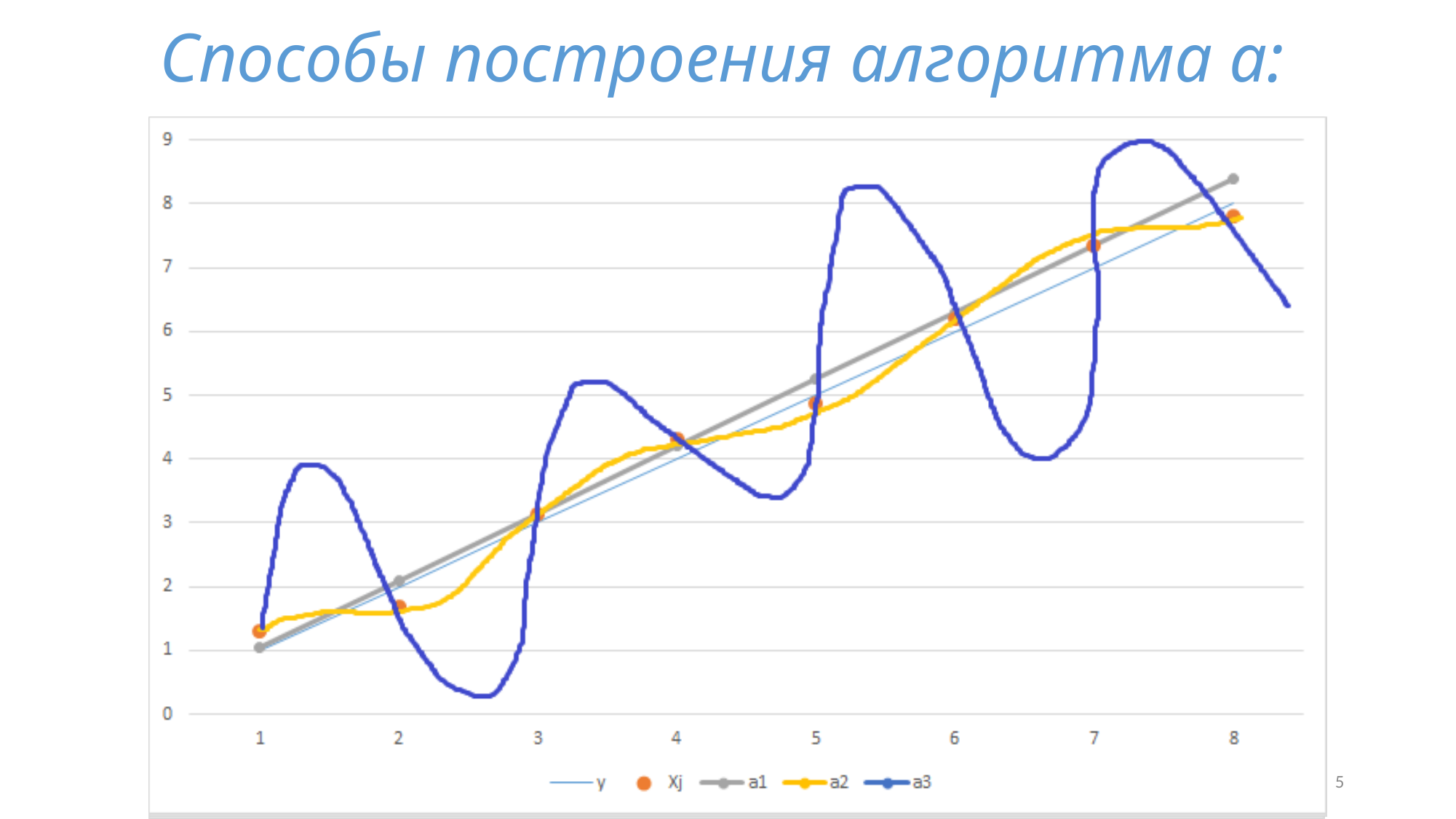
What are the series names listed in the legend? y, Xj, a1, a2, a3 What kind of chart is shown on the slide? line chart Does the a1 line rise or fall as x increases from 1 to 8? rises At which x value is the Xj point highest? 8 At x = 8, which is higher: a1 or Xj? a1 Is the value of Xj at x = 7 greater or less than 7? greater Is the value of a1 at x = 8 greater or less than 8? greater At which x value is the Xj point lowest? 1 How many series does the legend list? 5 Is the value of Xj at x = 2 greater or less than 2? less How many Xj points are plotted on the chart? 8